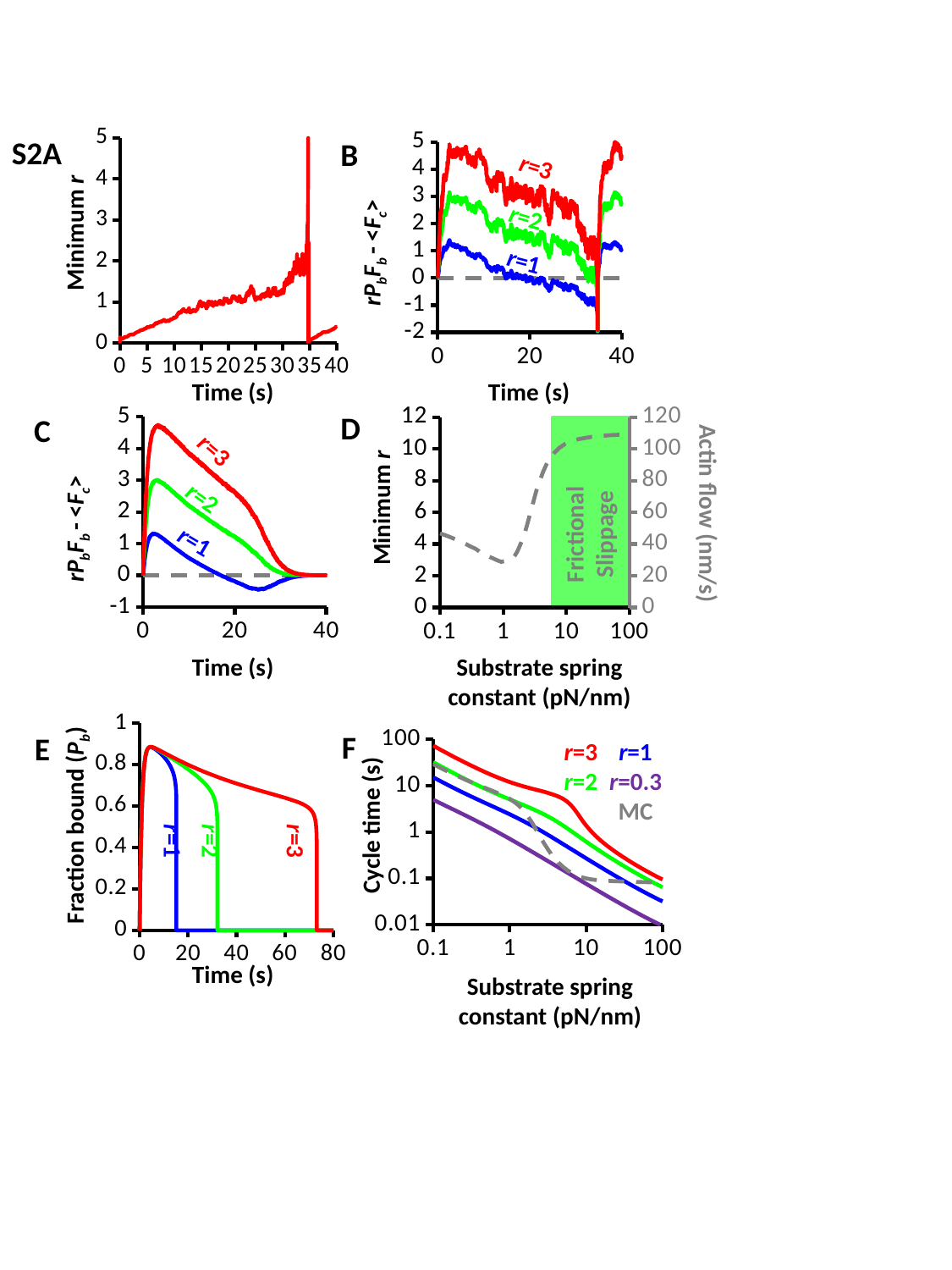
In panel S2A, is the value of Minimum r at 30 s greater or less than 2? less In panel D, what label is written inside the green shaded region? Frictional Slippage In panel B, how many r values are labeled on the plotted curves? 3 In panel C, which is larger at 10 s, the r=3 curve or the r=1 curve? r=3 In panel F, which labeled series has the lowest cycle time at 100 pN/nm? r=0.3 In panel D, what is the x-axis title? Substrate spring constant (pN/nm) In panel E, does the r=3 curve drop to zero at a time greater or less than 60 s? greater In panel E, which labeled series drops to zero first? r=1 In panel C, is the peak value of the r=3 curve greater or less than 4? greater In panel B, which labeled series has the highest values? r=3 In panel F, does cycle time rise or fall as the substrate spring constant increases? fall What kind of chart is panel S2A (Minimum r versus Time)? line chart